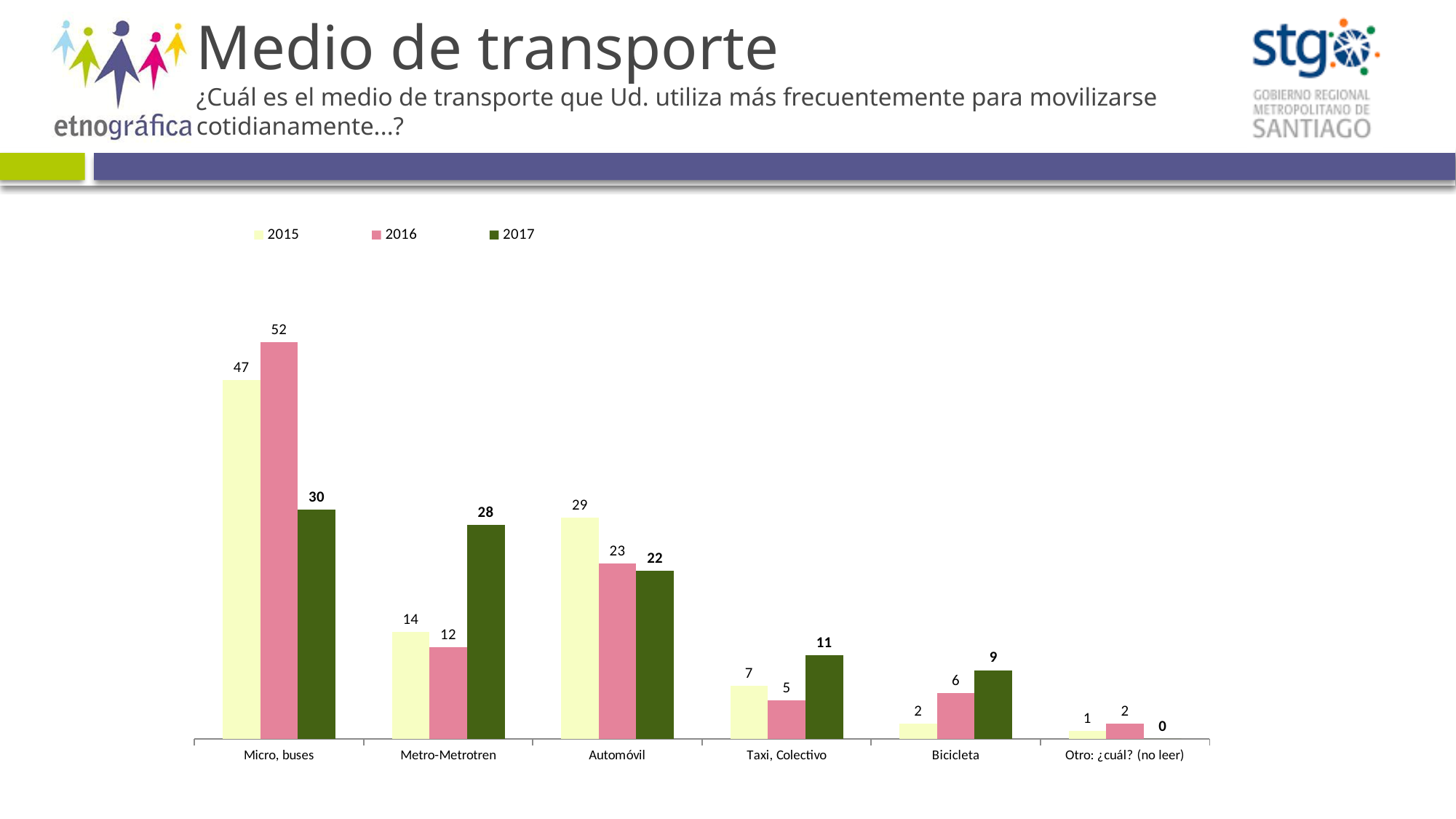
Which category has the lowest value in the 2015 series? Otro: ¿cuál? (no leer) What is the difference between the 2016 and 2017 values for Micro, buses? 22 Which is larger for Taxi, Colectivo: the 2015 value or the 2017 value? 2017 Which series is shown in dark green? 2017 How many categories are shown on the x axis? 6 What is the value for Metro-Metrotren in 2017? 28 Which category has the highest value in the 2017 series? Micro, buses What kind of chart is shown on the slide? Bar chart What is the value for Bicicleta in 2017? 9 How many series does the legend list? 3 What is the value for Micro, buses in 2016? 52 What is the value for Automóvil in 2015? 29